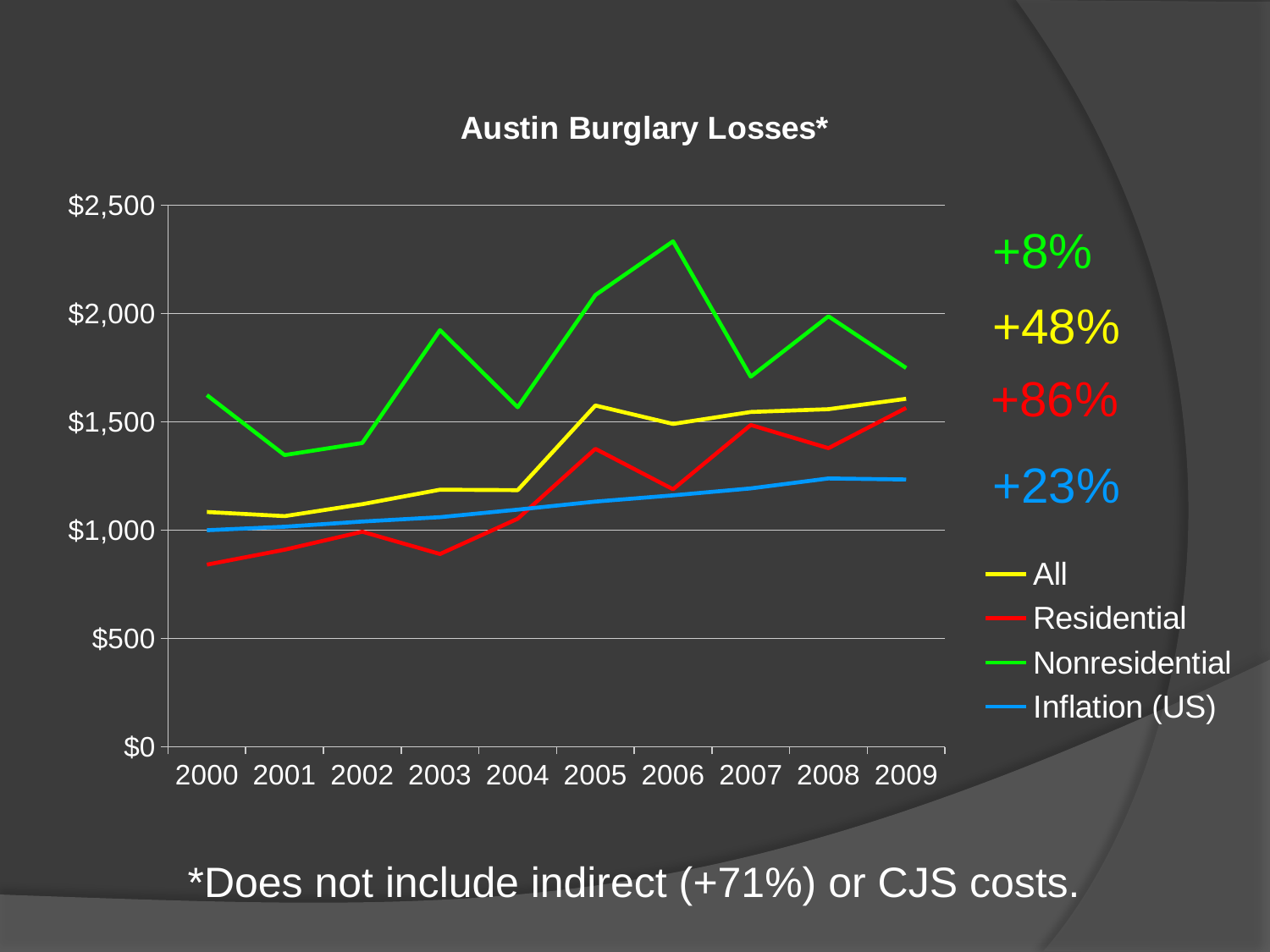
In which year does the Nonresidential line reach its highest point? 2006 How many years are shown on the x axis? 10 How many series does the legend list? 4 Is the Residential value for 2000 greater or less than $1,000? less Which series has the highest value in 2006? Nonresidential Does the Inflation (US) line generally rise or fall from 2000 to 2009? rise What kind of chart is shown on the slide? line chart Is the Nonresidential value for 2006 greater or less than $2,000? greater What is the title of the chart? Austin Burglary Losses* In 2005, which is larger, the Nonresidential value or the All value? Nonresidential Which series has the lowest value in 2000? Residential Is the Inflation (US) value for 2009 greater or less than $1,500? less